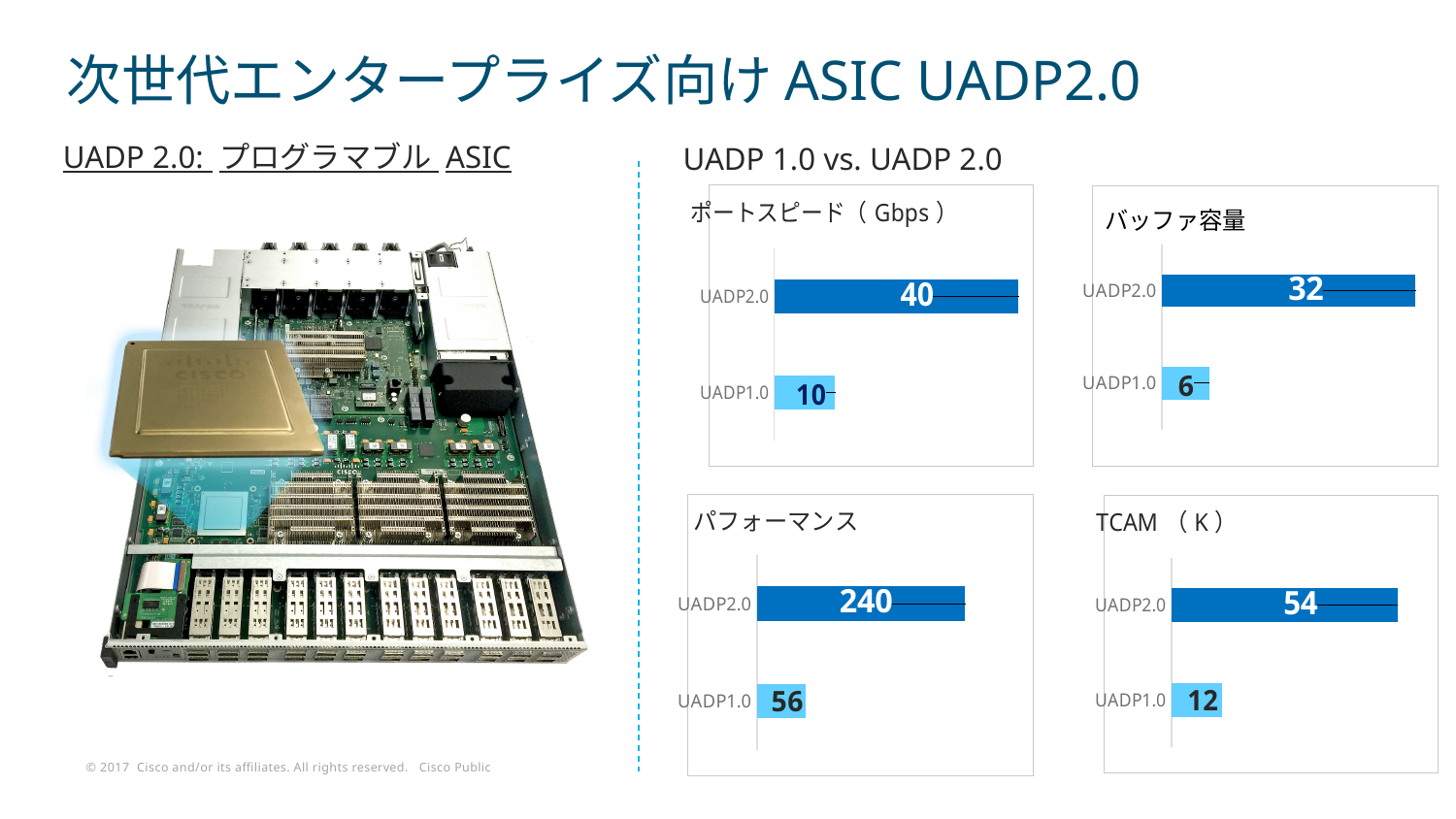
In the ポートスピード (Gbps) chart, which category has the lowest value? UADP1.0 In the バッファ容量 chart, what is the value for UADP2.0? 32 In the パフォーマンス chart, what is the difference between the UADP2.0 and UADP1.0 values? 184 What kind of chart is the TCAM (K) chart? bar chart In the ポートスピード (Gbps) chart, what is the value for UADP1.0? 10 In the ポートスピード (Gbps) chart, what is the value for UADP2.0? 40 In the パフォーマンス chart, what is the value for UADP2.0? 240 In the TCAM (K) chart, what is the value for UADP1.0? 12 In the バッファ容量 chart, which has the larger value, UADP2.0 or UADP1.0? UADP2.0 In the バッファ容量 chart, what is the value for UADP1.0? 6 In the TCAM (K) chart, what is the difference between the UADP2.0 and UADP1.0 values? 42 How many categories are shown in the パフォーマンス chart? 2